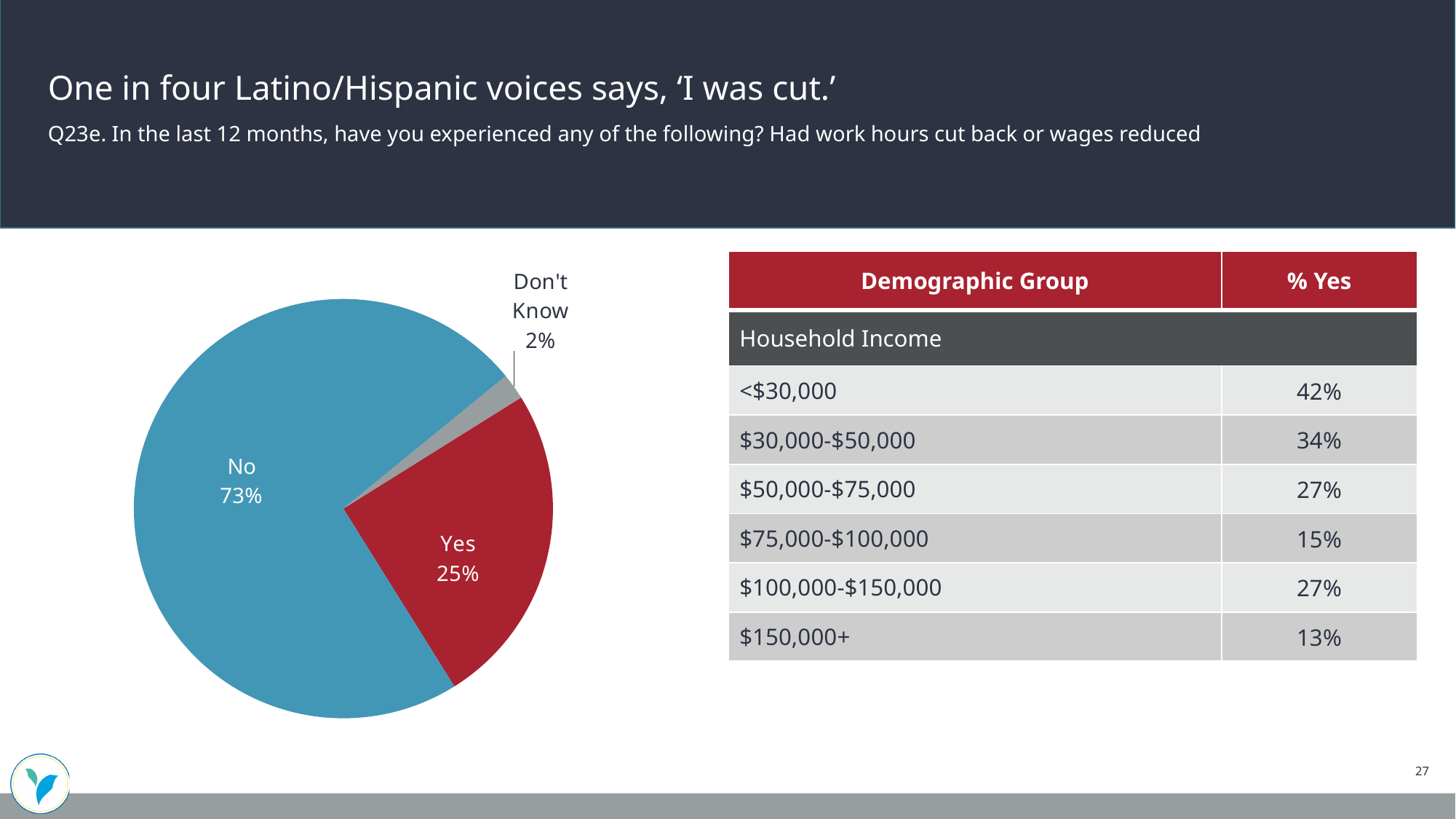
What kind of chart is shown on the slide? pie chart How many slices does the pie chart have? 3 What is the difference between the 'No' and 'Yes' shares in the pie chart? 48% What share of the pie chart is labelled 'No'? 73% What is the difference between the 'Yes' and 'Don't Know' shares in the pie chart? 23% Which slice of the pie chart is the largest? No What share of the pie chart is labelled 'Yes'? 25% What share of the pie chart is labelled 'Don't Know'? 2% What colour is the 'No' slice in the pie chart? blue What colour is the 'Yes' slice in the pie chart? red Which slice of the pie chart is the smallest? Don't Know Which is larger in the pie chart, the 'Yes' slice or the 'Don't Know' slice? Yes